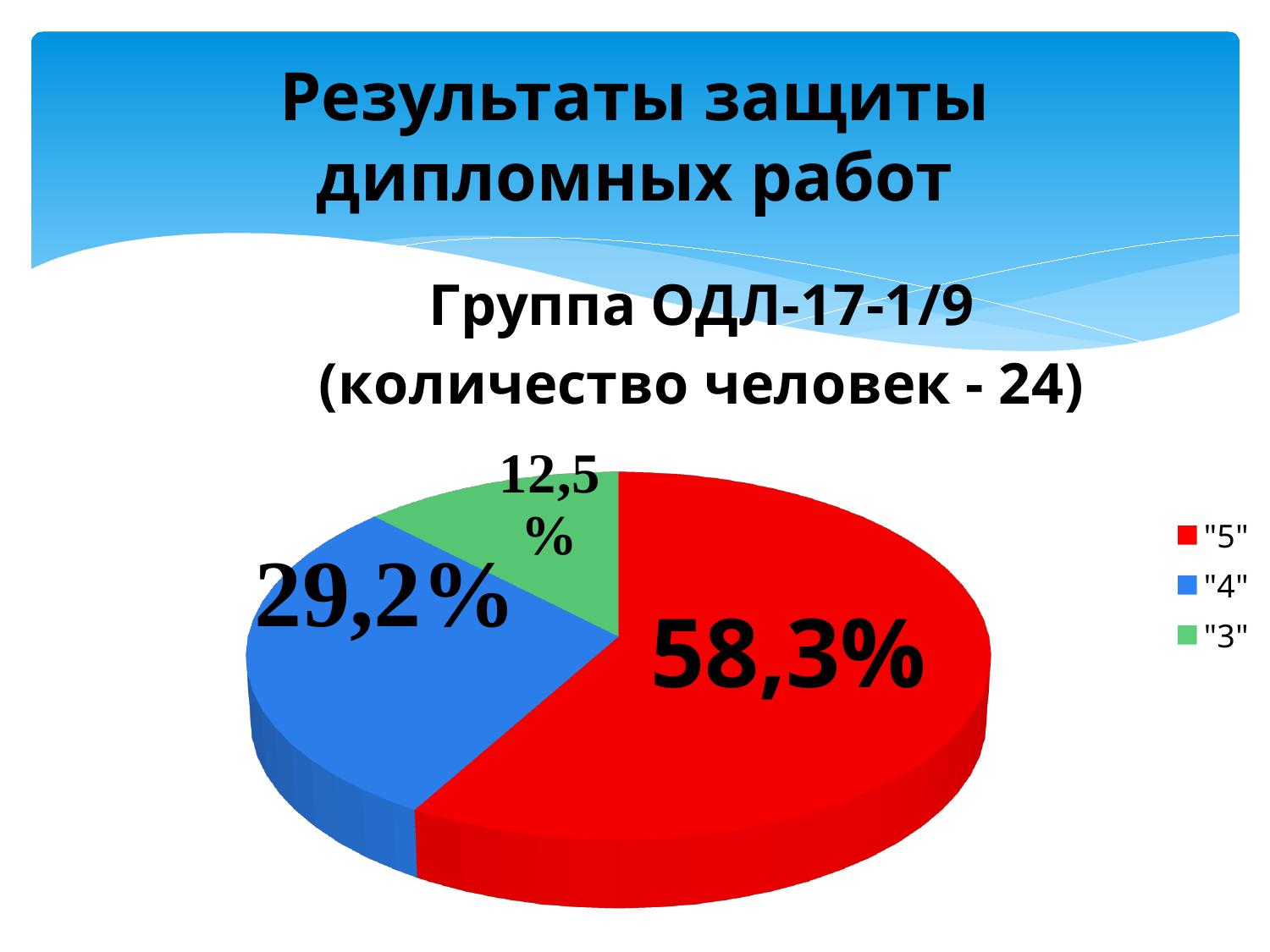
Which slice is larger, "4" or "3"? "4" What share of the pie does the "3" slice represent? 12,5% What is the difference in percentage points between the "5" slice and the "4" slice? 29,1 Which grade has the smallest slice of the pie? "3" What colour is the "4" slice in the pie chart? Blue What is the difference in percentage points between the "4" slice and the "3" slice? 16,7 What share of the pie does the "5" slice represent? 58,3% What kind of chart is shown on the slide? Pie chart What share of the pie does the "4" slice represent? 29,2% Which grade has the largest slice of the pie? "5" How many entries does the legend list? 3 How many slices does the pie chart have? 3